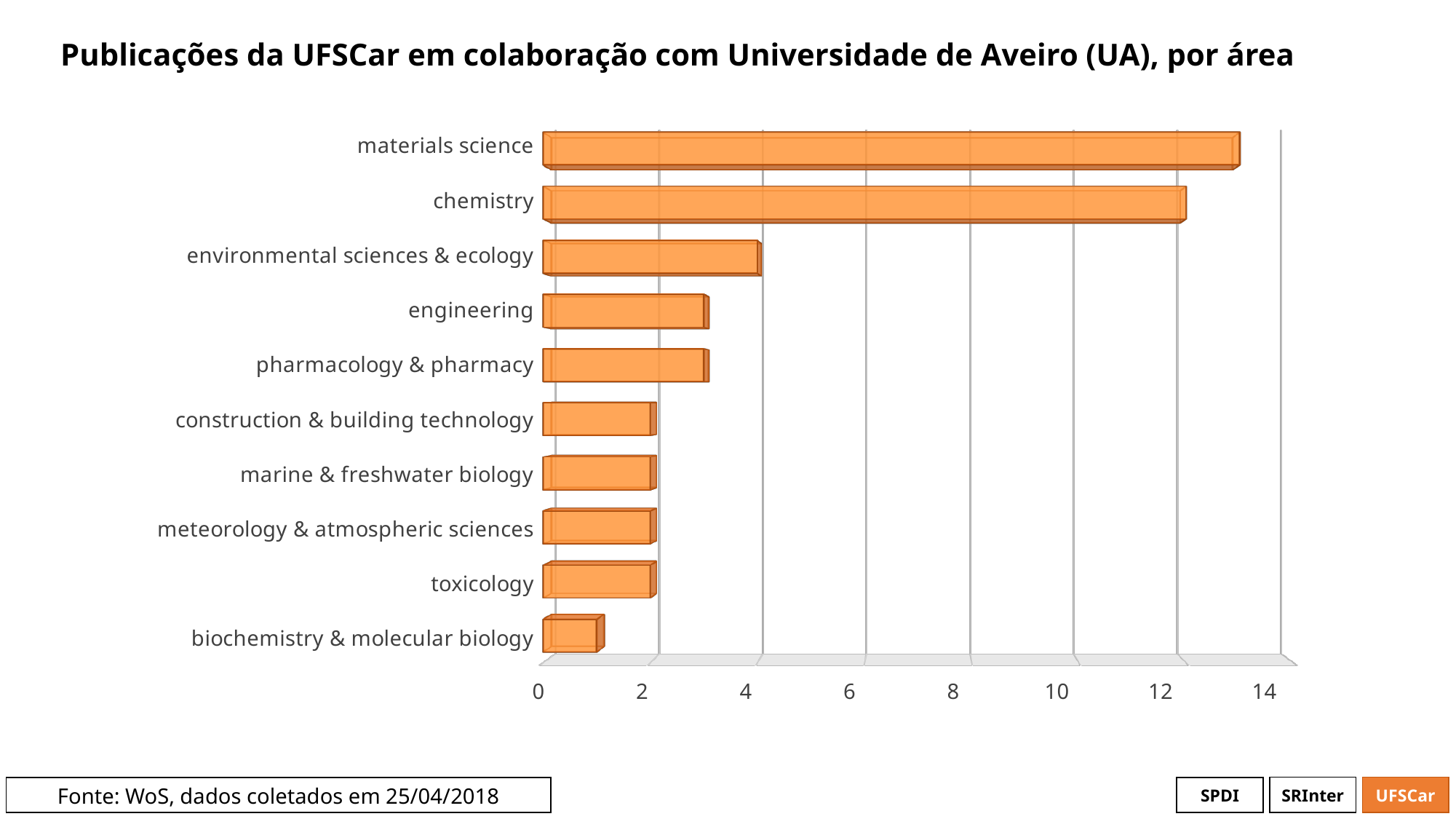
Which is larger, the value for chemistry or the value for environmental sciences & ecology? chemistry What is the difference between the values for chemistry and environmental sciences & ecology? 8 Which area has the highest number of publications? materials science How many areas are listed on the chart? 10 Is the value for engineering greater or less than 4? less What is the value for toxicology? 2 Which area has the lowest number of publications? biochemistry & molecular biology Is the value for materials science greater or less than 12? greater What kind of chart is shown on the slide? bar chart What is the value for environmental sciences & ecology? 4 What is the value for chemistry? 12 Is the value for biochemistry & molecular biology greater or less than 2? less